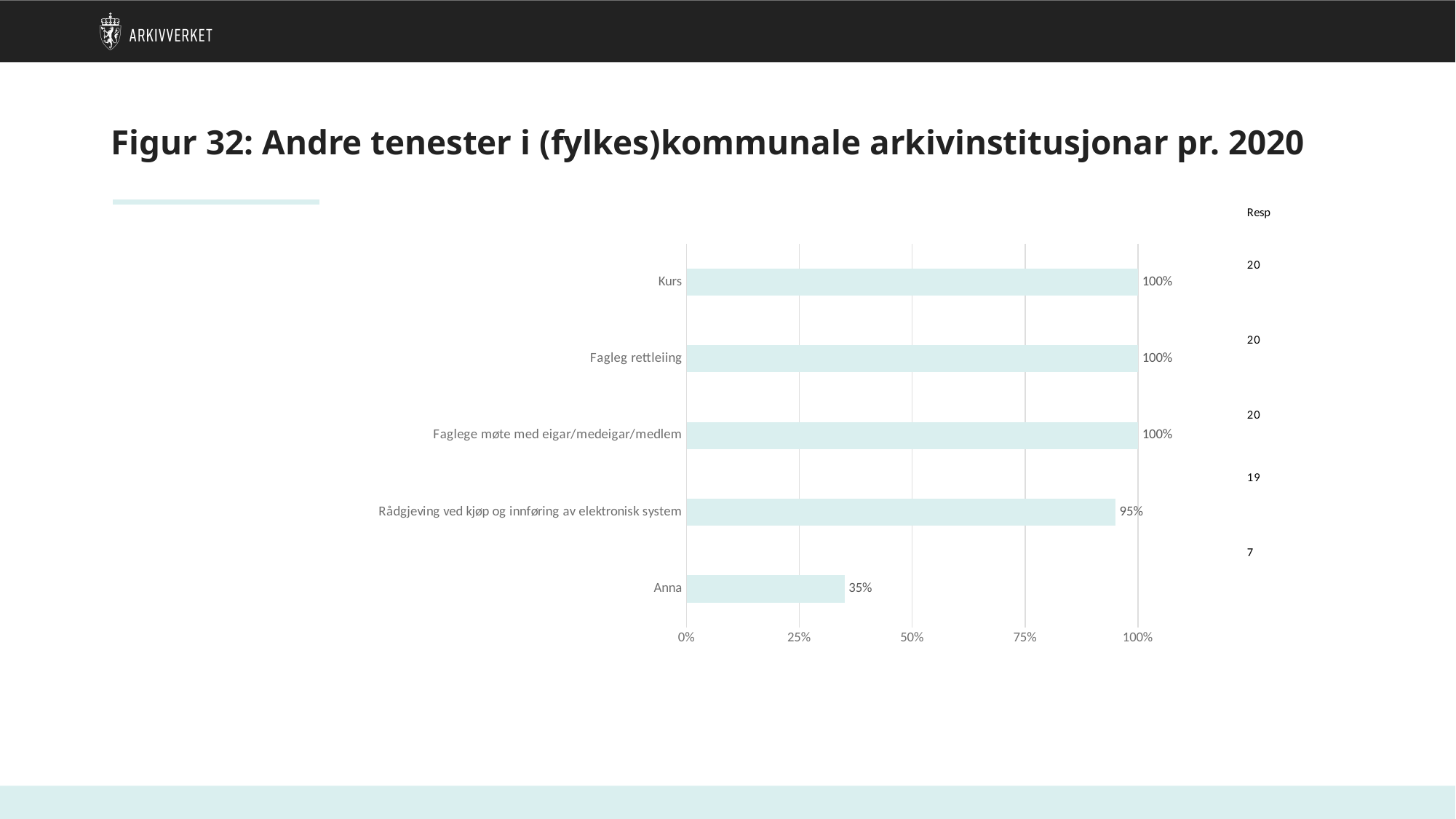
What kind of chart is shown on the slide? bar chart How many categories are shown in the chart? 5 What is the difference between the values for Rådgjeving ved kjøp og innføring av elektronisk system and Anna? 60% Is the value for Anna greater or less than 50%? less How many categories have a value of 100%? 3 What is the title of the slide? Figur 32: Andre tenester i (fylkes)kommunale arkivinstitusjonar pr. 2020 Which is larger, the value for Faglege møte med eigar/medeigar/medlem or the value for Anna? Faglege møte med eigar/medeigar/medlem What is the value for Fagleg rettleiing? 100% Which category has the lowest value? Anna What is the value for Anna? 35% What is the value for Kurs? 100% What is the value for Rådgjeving ved kjøp og innføring av elektronisk system? 95%